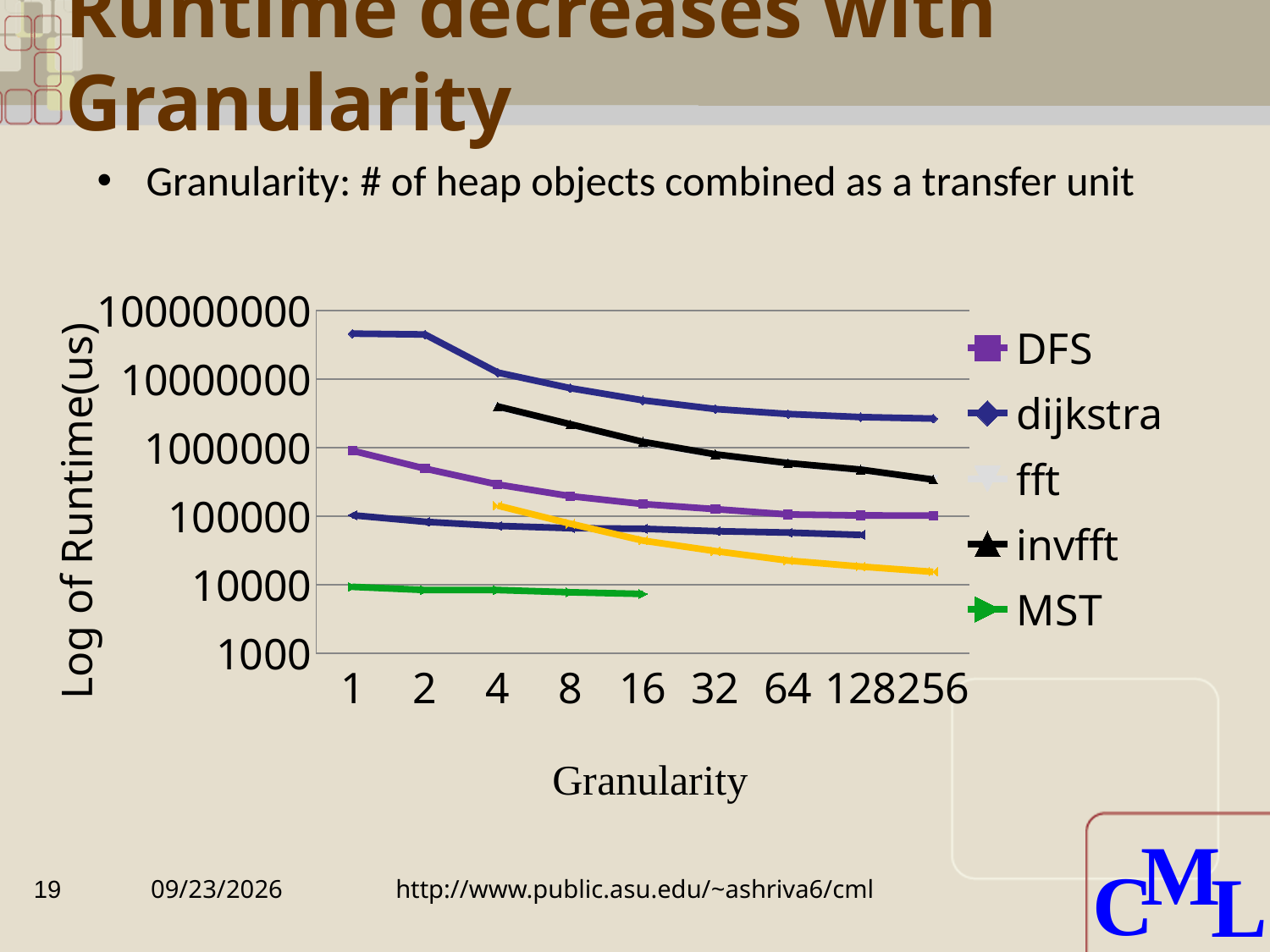
How many series does the legend list? 5 What kind of chart is shown on the slide? line chart At granularity 8, which series has the larger runtime, invfft or DFS? invfft What is the highest tick value shown on the y axis? 100000000 What is the title of the y axis? Log of Runtime(us) Is the value for MST at granularity 16 greater or less than 100000? less Is the value for invfft at granularity 4 greater or less than 1000000? greater How many granularity values are labelled on the x axis? 9 Which series has the lowest runtime across the chart? MST Do the runtime values rise or fall as granularity increases along the x axis? fall Is the value for DFS at granularity 4 greater or less than 100000? greater How many data points does the MST series have? 5